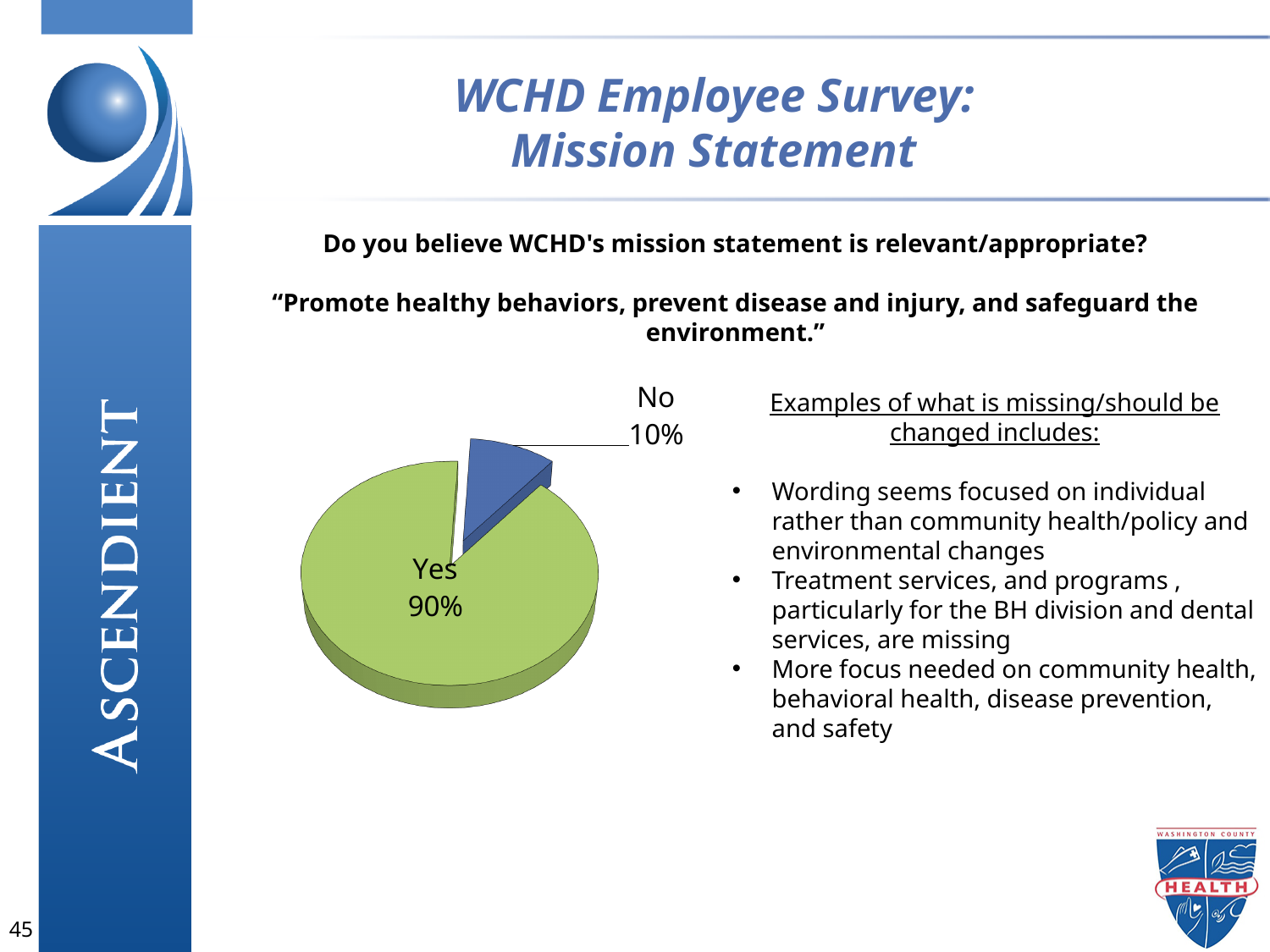
What colour is the Yes slice of the pie chart? Green What colour is the No slice of the pie chart? Blue What kind of chart is shown on the slide? Pie chart Which response has the smallest share of the pie? No Which is larger, the Yes share or the No share? Yes What percentage of respondents answered No? 10% How many slices does the pie chart have? 2 What is the difference in percentage points between the Yes and No shares? 80 What percentage of respondents answered Yes? 90% What share of the pie does the No slice represent? 10% Which response has the largest share of the pie? Yes